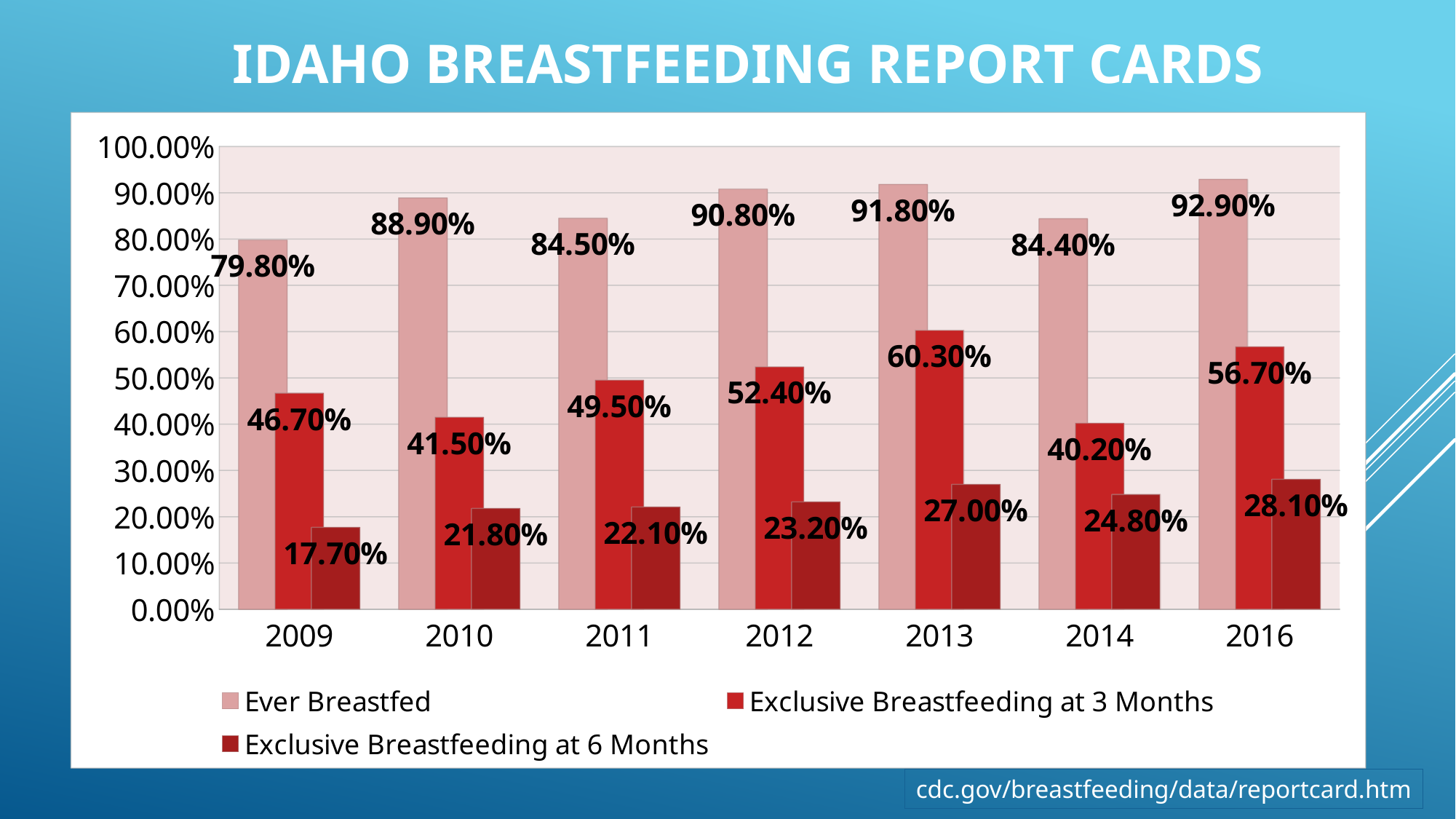
How many series does the legend list? 3 What is the title of the slide? IDAHO BREASTFEEDING REPORT CARDS What kind of chart is shown on the slide? bar chart Is the Exclusive Breastfeeding at 6 Months value for 2013 greater or less than 30.00%? less What is the Exclusive Breastfeeding at 6 Months value for 2009? 17.70% What is the Ever Breastfed value for 2016? 92.90% Which is larger, the Exclusive Breastfeeding at 3 Months value for 2012 or for 2014? 2012 How many years are shown on the x axis? 7 What is the difference between the Ever Breastfed values for 2016 and 2009? 13.10% Which year has the lowest Exclusive Breastfeeding at 6 Months value? 2009 What is the Exclusive Breastfeeding at 3 Months value for 2013? 60.30% Which year has the highest Ever Breastfed value? 2016